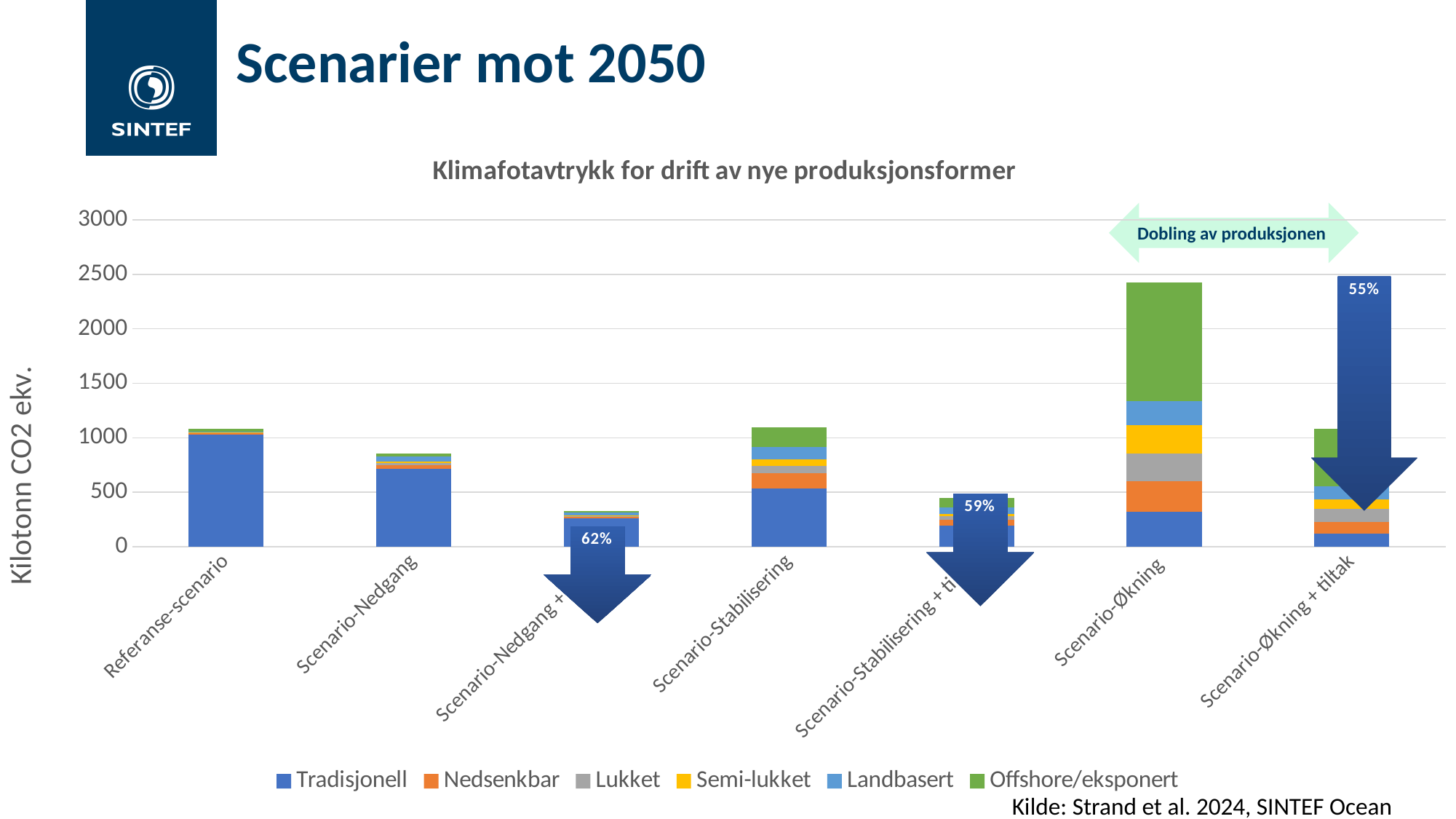
What kind of chart is shown on the slide? bar chart Is the total for Scenario-Nedgang + tiltak greater or less than 500? less What percentage reduction is shown on the arrow for Scenario-Økning + tiltak? 55% Which scenario has the highest total climate footprint? Scenario-Økning Is the total for Referanse-scenario greater or less than 1000? greater Which is larger, the total for Scenario-Stabilisering or the total for Scenario-Nedgang? Scenario-Stabilisering Is the total for Scenario-Økning greater or less than 2000? greater What is the title of the chart? Klimafotavtrykk for drift av nye produksjonsformer How many series does the legend list? 6 What is the label on the y axis? Kilotonn CO2 ekv. Which scenario has the lowest total climate footprint? Scenario-Nedgang + tiltak How many scenario categories are shown on the x axis? 7